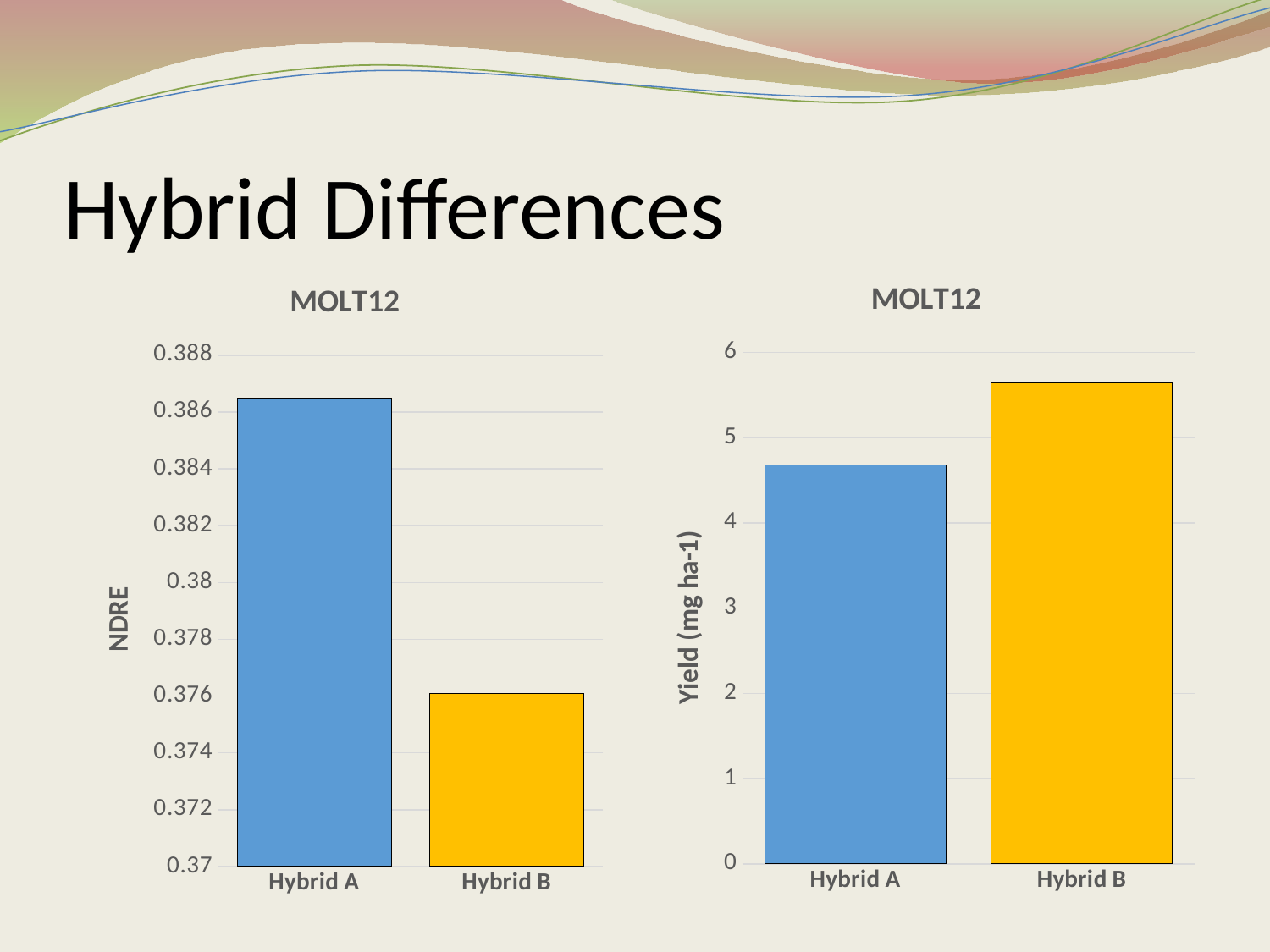
What type of chart is the right chart (Yield)? Bar chart In the left chart (NDRE), is the value for Hybrid B greater or less than 0.378? less In the right chart (Yield), is the value for Hybrid A greater or less than 5? less In the left chart (NDRE), which hybrid has the higher NDRE value? Hybrid A In the right chart (Yield), which hybrid has the higher yield? Hybrid B How many categories are shown in the left chart (NDRE)? 2 In the right chart (Yield), which hybrid has the lower yield? Hybrid A What is the y-axis label of the right chart? Yield (mg ha-1) In the right chart (Yield), is the yield for Hybrid B larger or smaller than the yield for Hybrid A? larger In the left chart (NDRE), which hybrid has the lower NDRE value? Hybrid B In the left chart (NDRE), is the value for Hybrid A greater or less than 0.386? greater